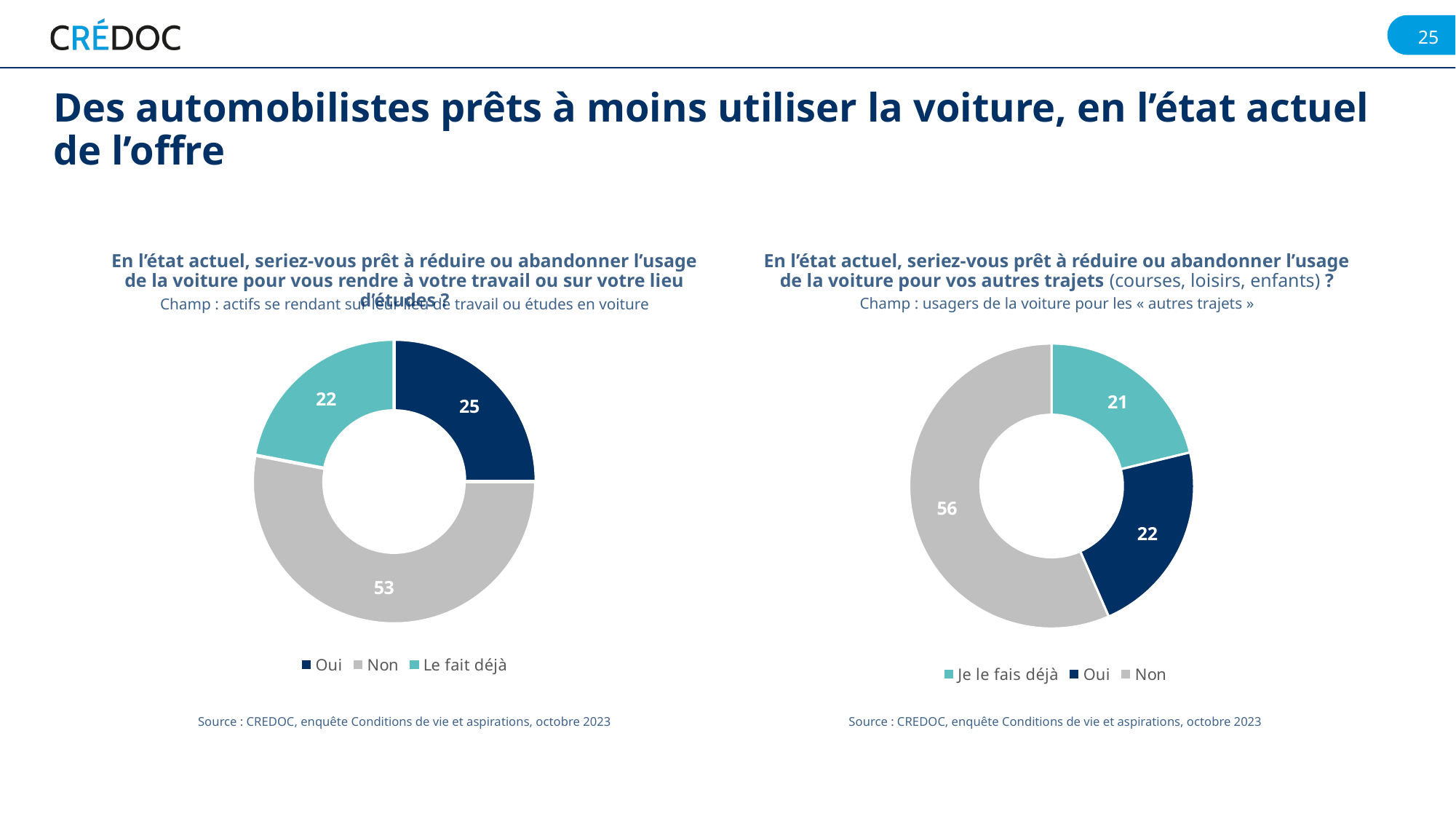
In the left chart, what is the difference between the values for "Non" and "Oui"? 28 In the left chart, what is the value for "Non"? 53 In the right chart, what is the difference between the values for "Non" and "Oui"? 34 In the left chart, which category has the smallest value? Le fait déjà In the right chart, what is the value for "Je le fais déjà"? 21 In the right chart, which category has the largest value? Non In the left chart, what is the value for "Oui"? 25 In the right chart, what is the value for "Non"? 56 What kind of chart is the left chart? Doughnut chart In the left chart, what is the value for "Le fait déjà"? 22 In the left chart, which is larger, the value for "Oui" or the value for "Le fait déjà"? Oui How many categories does the right chart show? 3